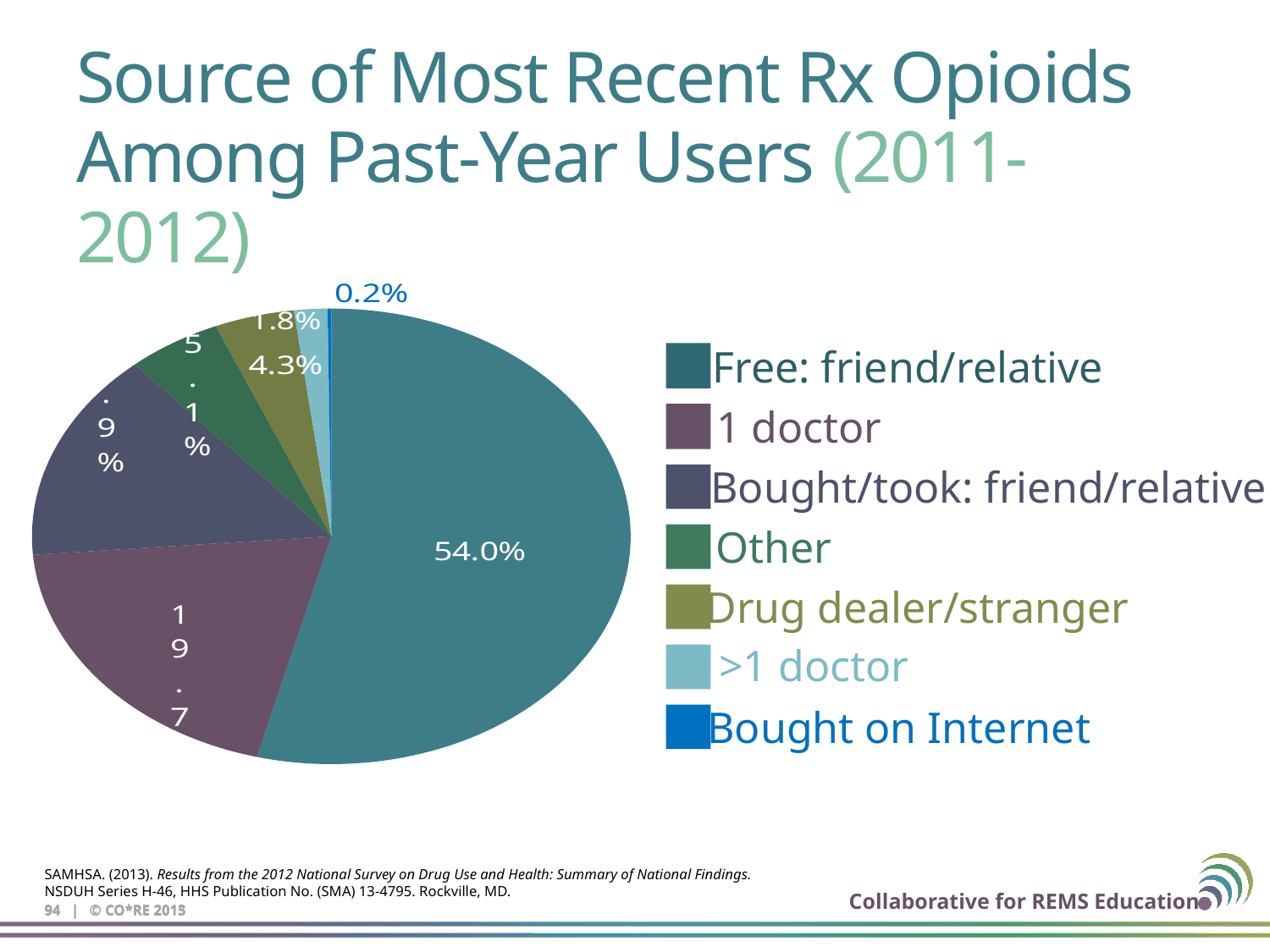
What kind of chart is shown on the slide? pie chart Which source accounts for the largest slice of the pie? Free: friend/relative How many sources are listed in the legend? 7 What percentage is shown for Drug dealer/stranger? 4.3% What colour is used for the Bought on Internet slice in the legend? blue Which slice is larger: 1 doctor or Bought/took: friend/relative? 1 doctor What is the difference between the Drug dealer/stranger share and the >1 doctor share? 2.5% What percentage is shown for Other? 5.1% Which source accounts for the smallest slice of the pie? Bought on Internet What percentage is shown for Bought on Internet? 0.2% What share of the pie is labelled for Free: friend/relative? 54.0% What percentage is shown for >1 doctor? 1.8%